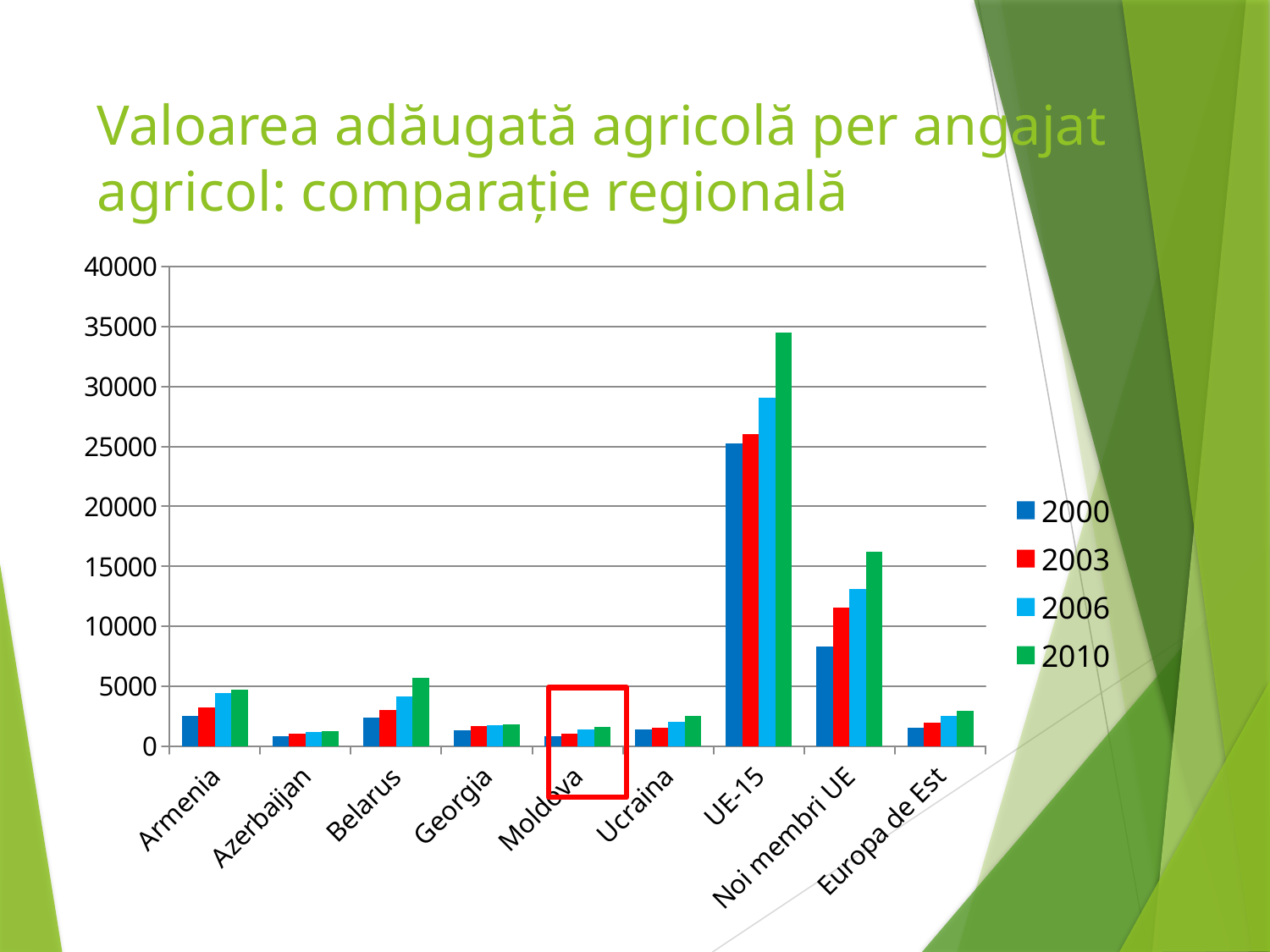
Which year has the lowest value for Noi membri UE? 2000 Which category has the highest value for 2000? UE-15 How many countries or regions are shown on the x axis of the chart? 9 Is the value for Belarus in 2010 greater or less than 5000? greater Which category has the highest value for 2010? UE-15 Do the values for UE-15 rise or fall from 2000 to 2010? rise Which is larger, the 2010 value for UE-15 or the 2010 value for Noi membri UE? UE-15 Is the value for UE-15 in 2010 greater or less than 30000? greater Which category on the x axis is highlighted with a red box? Moldova Is the value for Noi membri UE in 2000 greater or less than 10000? less How many series does the chart legend list? 4 What kind of chart is shown on the slide? bar chart